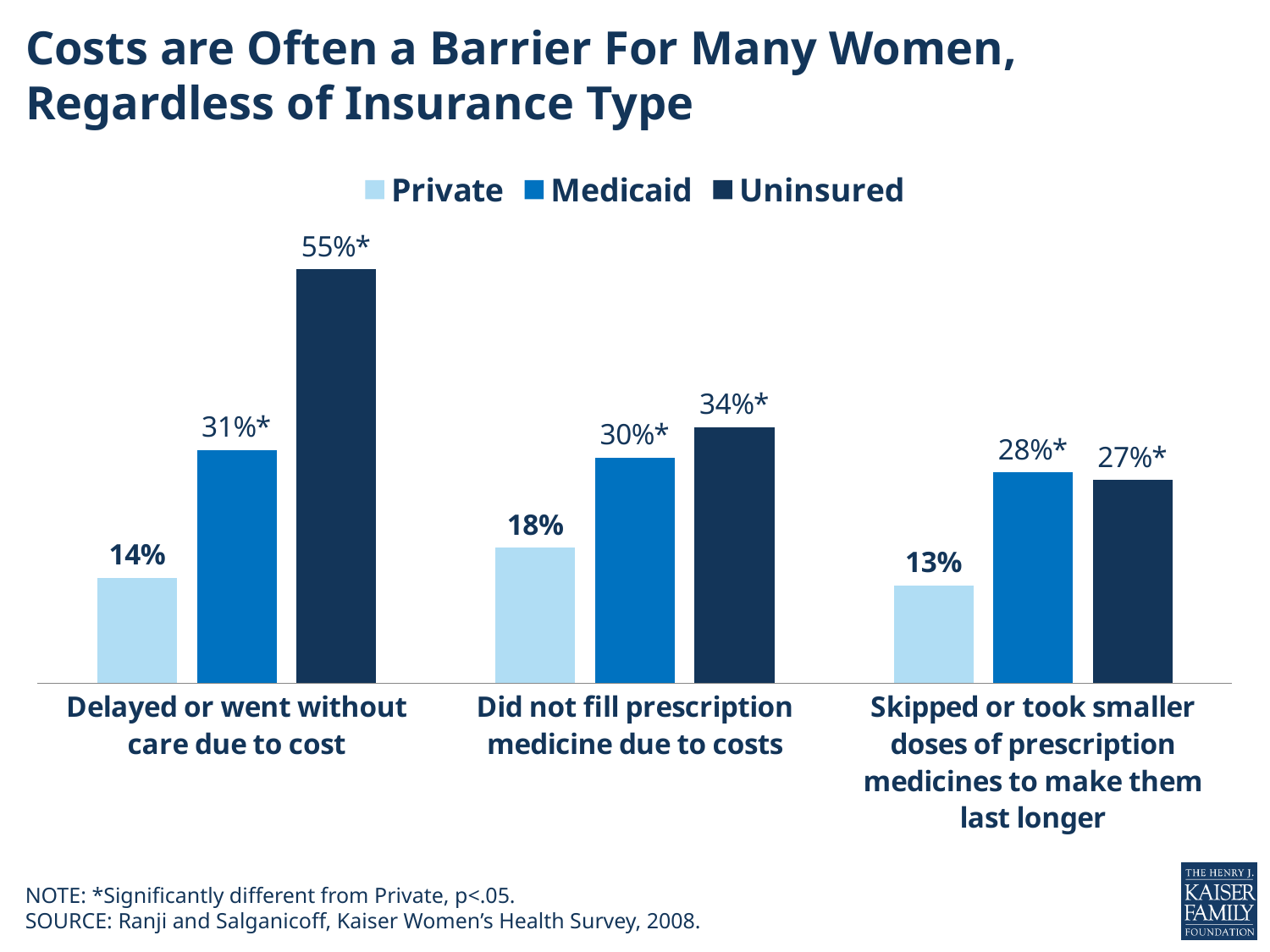
How many categories are shown on the x axis? 3 What is the difference between the Medicaid and Uninsured values for 'Did not fill prescription medicine due to costs'? 4 percentage points Which insurance type has the lowest value for 'Skipped or took smaller doses of prescription medicines to make them last longer'? Private How many series does the legend list? 3 What is the difference between the Uninsured and Private values for 'Delayed or went without care due to cost'? 41 percentage points What is the value for Private insurance in the 'Did not fill prescription medicine due to costs' category? 18% What is the value for Medicaid in the 'Skipped or took smaller doses of prescription medicines to make them last longer' category? 28% What is the value for Uninsured women who delayed or went without care due to cost? 55% What kind of chart is shown on the slide? bar chart Which insurance type has the highest value for 'Delayed or went without care due to cost'? Uninsured Which is larger for 'Did not fill prescription medicine due to costs': the Medicaid value or the Private value? Medicaid Which series is shown in the lightest blue colour in the legend? Private